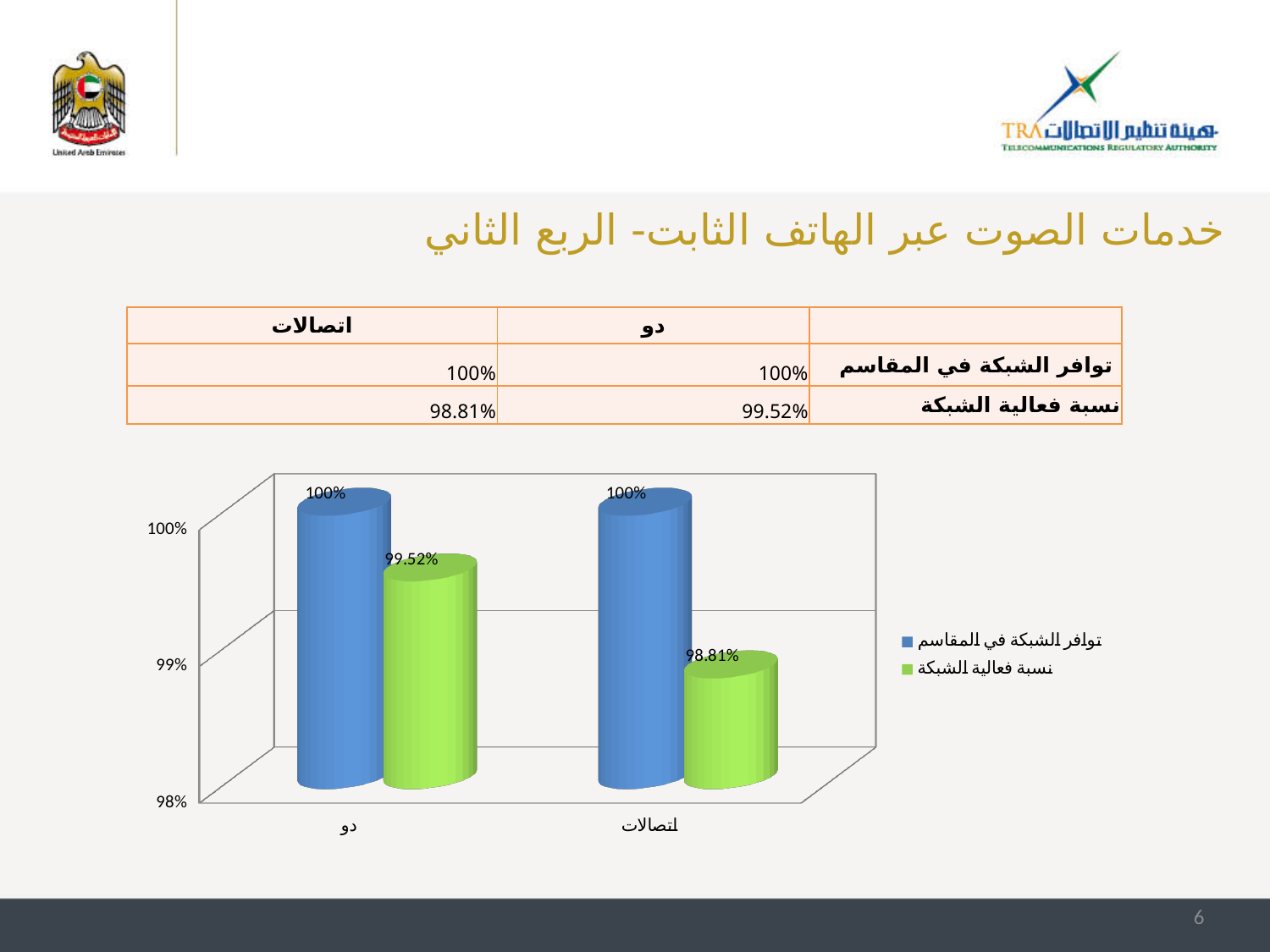
Is the نسبة فعالية الشبكة value for اتصالات greater or less than 99%? less What is the value of نسبة فعالية الشبكة for اتصالات in the chart? 98.81% How many series does the chart legend list? 2 What type of chart is shown on the slide? bar chart Which operator has the lower نسبة فعالية الشبكة in the chart? اتصالات Which colour represents نسبة فعالية الشبكة in the chart? green What is the difference between the نسبة فعالية الشبكة values for دو and اتصالات? 0.71% What is the value of توافر الشبكة في المقاسم for دو in the chart? 100% What is the value of نسبة فعالية الشبكة for دو in the chart? 99.52% How many operator categories are shown on the x axis of the chart? 2 Which operator has the higher نسبة فعالية الشبكة in the chart? دو What is the value of توافر الشبكة في المقاسم for اتصالات in the chart? 100%